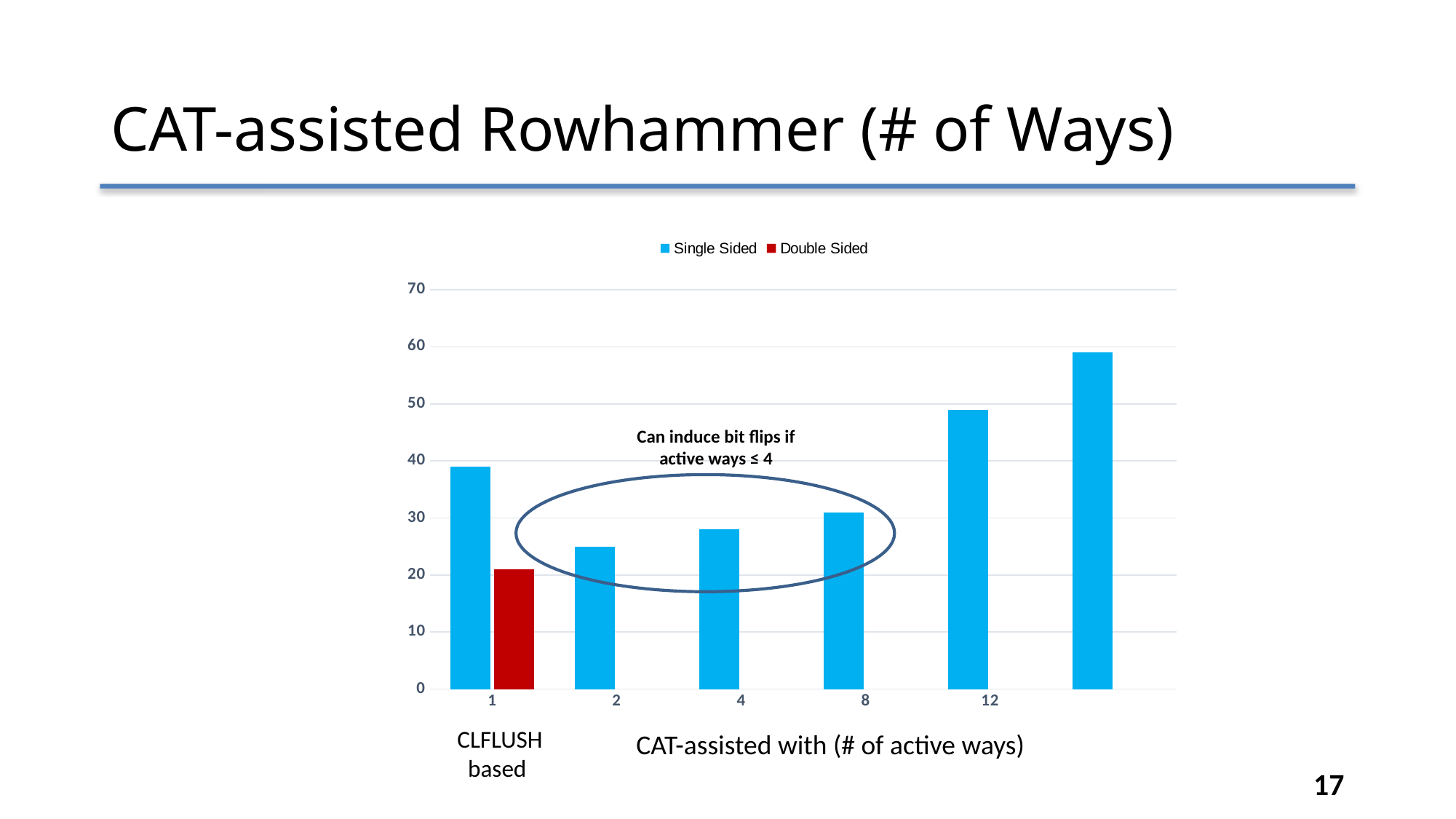
How many series does the legend list? 2 For category 1, which is larger: the Single Sided value or the Double Sided value? Single Sided What colour are the Double Sided bars? red What are the two series named in the legend? Single Sided and Double Sided Which has the larger Single Sided value: category 2 or category 12? 12 Is the Single Sided value for category 12 greater or less than 40? greater Do the Single Sided values rise or fall going from category 2 to category 12? rise Is the Single Sided value for category 8 greater or less than 40? less Is the Single Sided value for category 2 greater or less than 30? less What kind of chart is shown on the slide? bar chart